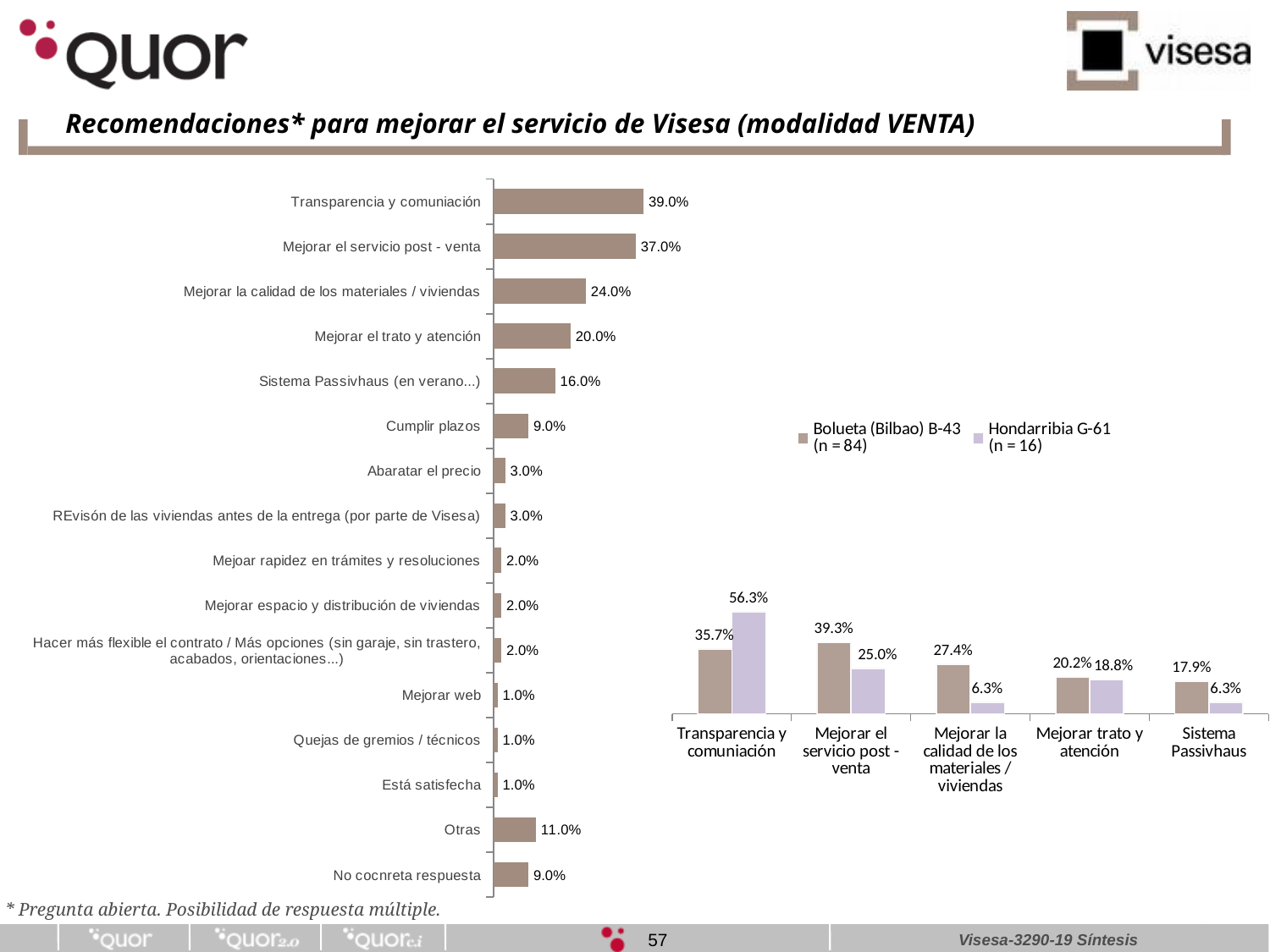
In the left chart, what is the difference between 'Mejorar la calidad de los materiales / viviendas' and 'Mejorar el trato y atención'? 4.0% In the left chart, which category has the highest value? Transparencia y comuniación What kind of chart is the right chart? Bar chart In the right chart, what is the value for Bolueta (Bilbao) B-43 for 'Mejorar el servicio post - venta'? 39.3% In the left chart, which is larger, 'Cumplir plazos' or 'Otras'? Otras In the right chart, what is the difference between Bolueta (Bilbao) B-43 and Hondarribia G-61 for 'Mejorar la calidad de los materiales / viviendas'? 21.1% In the right chart, what is the value for Hondarribia G-61 for 'Transparencia y comuniación'? 56.3% In the right chart, what is the sample size (n) for Bolueta (Bilbao) B-43 shown in the legend? 84 In the left chart, how many categories are shown? 16 In the right chart, how many series does the legend list? 2 In the left chart, what is the value for 'Mejorar el servicio post - venta'? 37.0% In the left chart, what is the value for 'Sistema Passivhaus (en verano...)'? 16.0%